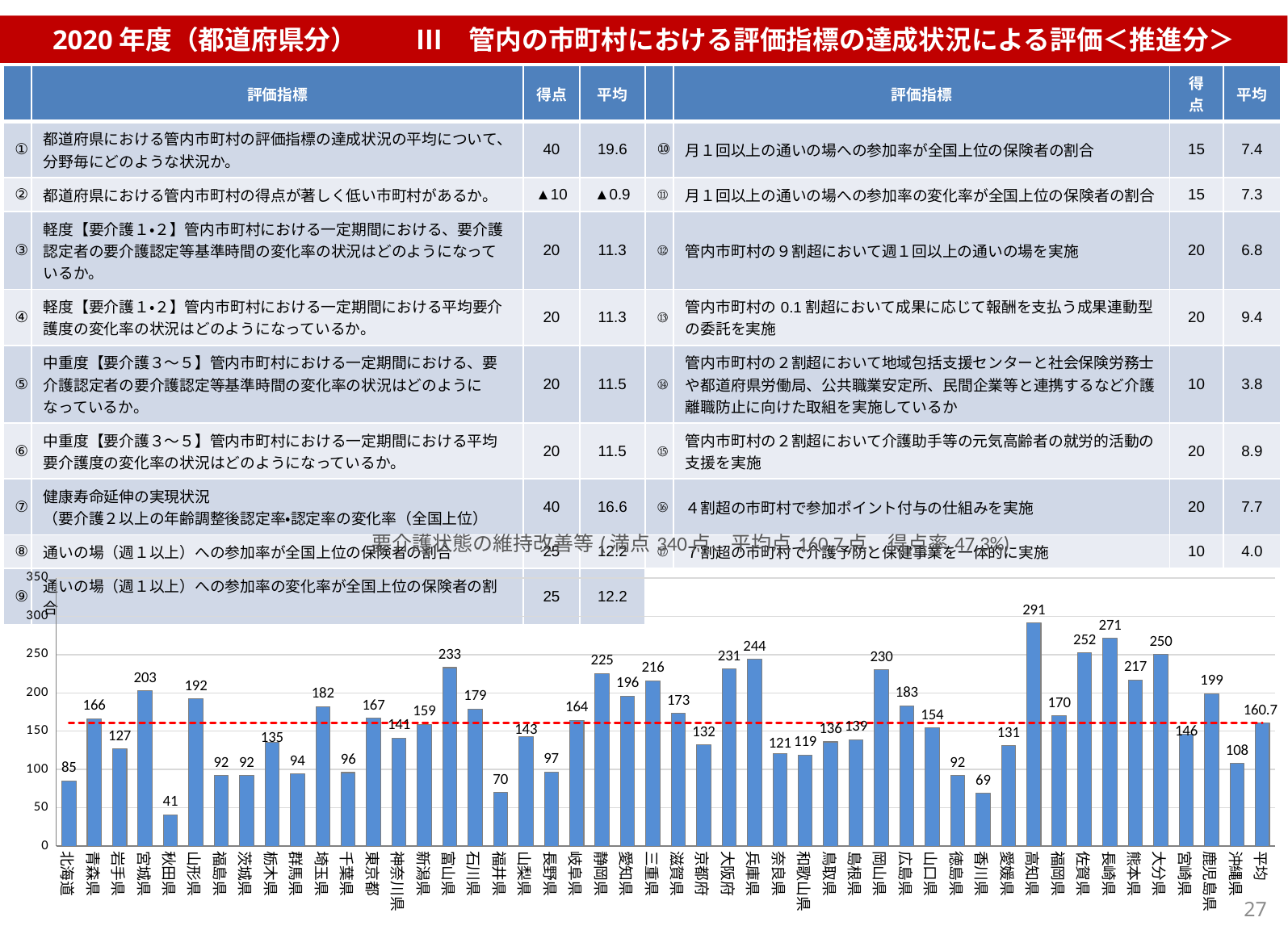
What is the difference between the values for 東京都 and 神奈川県 in the bar chart? 26 What kind of chart is shown at the bottom of the slide? bar chart What is the difference between the values for 長崎県 and 佐賀県 in the bar chart? 19 Is the value for 富山県 greater or less than 200? greater Which has a larger value in the bar chart, 兵庫県 or 大阪府? 兵庫県 What is the value shown for 平均 at the right end of the bar chart? 160.7 Which prefecture has the lowest value in the bar chart? 秋田県 Is the value for 香川県 greater or less than 100? less Which prefecture has the highest value in the bar chart? 高知県 What is the value for 秋田県 in the bar chart? 41 What is the value for 高知県 in the bar chart? 291 What is the value for 宮城県 in the bar chart? 203